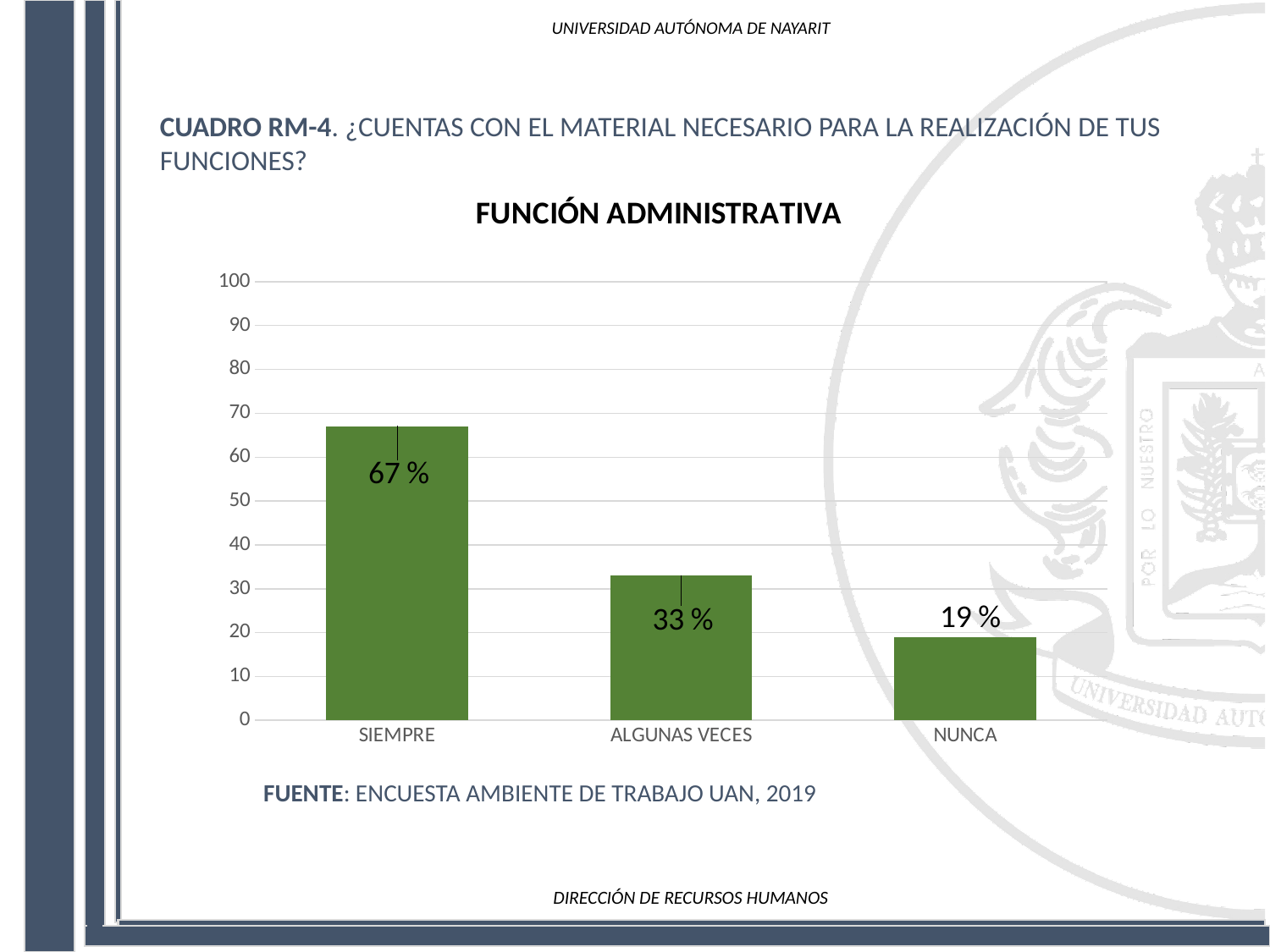
Which category has the lowest value? NUNCA What is the title of the chart? FUNCIÓN ADMINISTRATIVA What is the difference between the values for ALGUNAS VECES and NUNCA? 14 % Is the value for SIEMPRE greater or less than 60? greater What is the value for SIEMPRE? 67 % What is the difference between the values for SIEMPRE and ALGUNAS VECES? 34 % What is the value for NUNCA? 19 % How many categories are shown on the x axis? 3 What is the value for ALGUNAS VECES? 33 % Which category has the highest value? SIEMPRE What kind of chart is shown on the slide? bar chart Which is larger, the value for ALGUNAS VECES or the value for NUNCA? ALGUNAS VECES